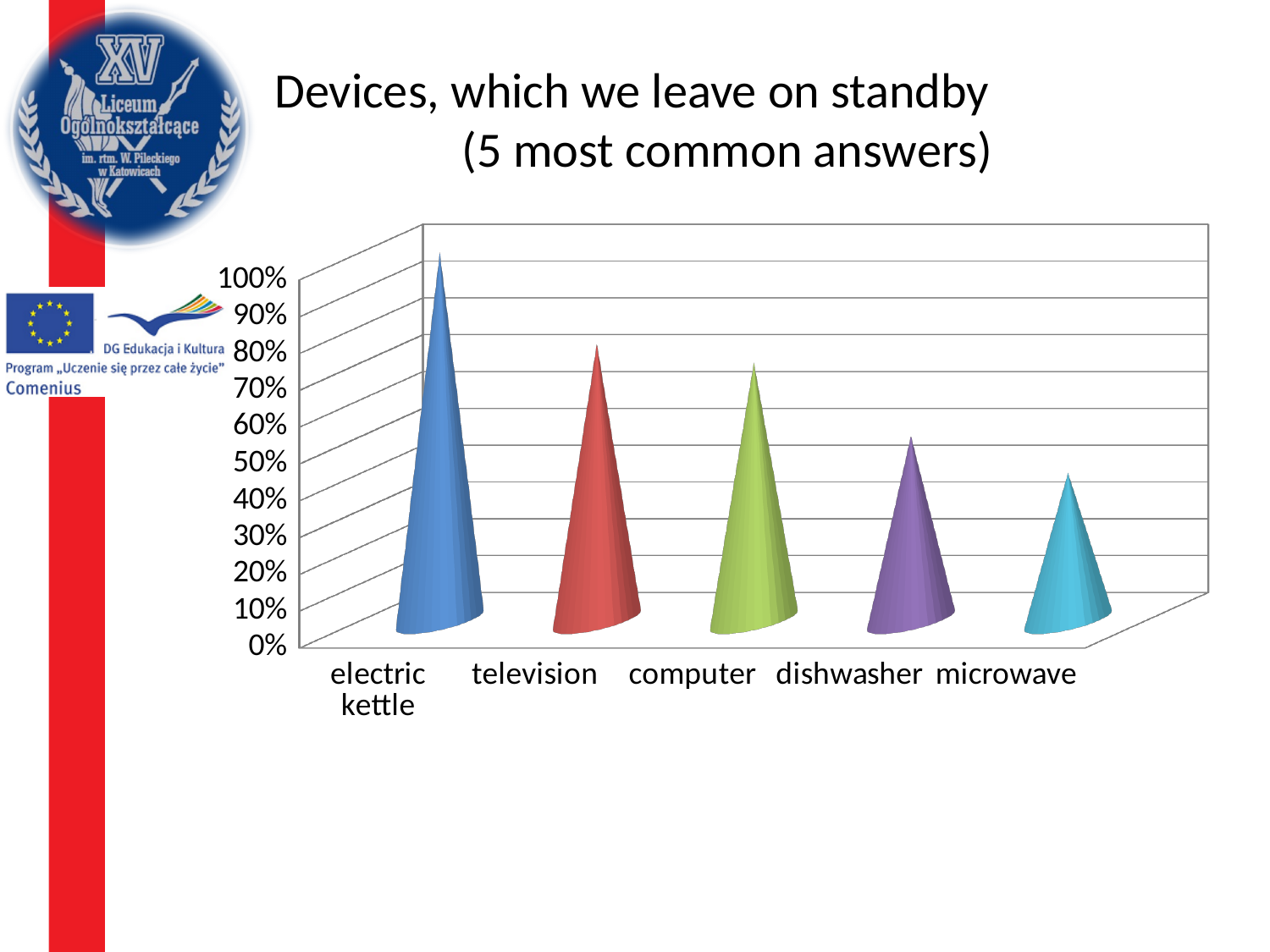
Is the value for television greater or less than 50%? greater Is the value for electric kettle greater or less than 80%? greater What kind of chart is shown on the slide? bar chart Which has a larger value, television or dishwasher? television How many devices are shown on the x axis of the chart? 5 Which device has the lowest value in the chart? microwave Do the values rise or fall from left to right along the x axis? fall What is the title of the chart on the slide? Devices, which we leave on standby (5 most common answers) Is the value for microwave greater or less than 60%? less Which has a larger value, computer or microwave? computer Which device has the highest value in the chart? electric kettle